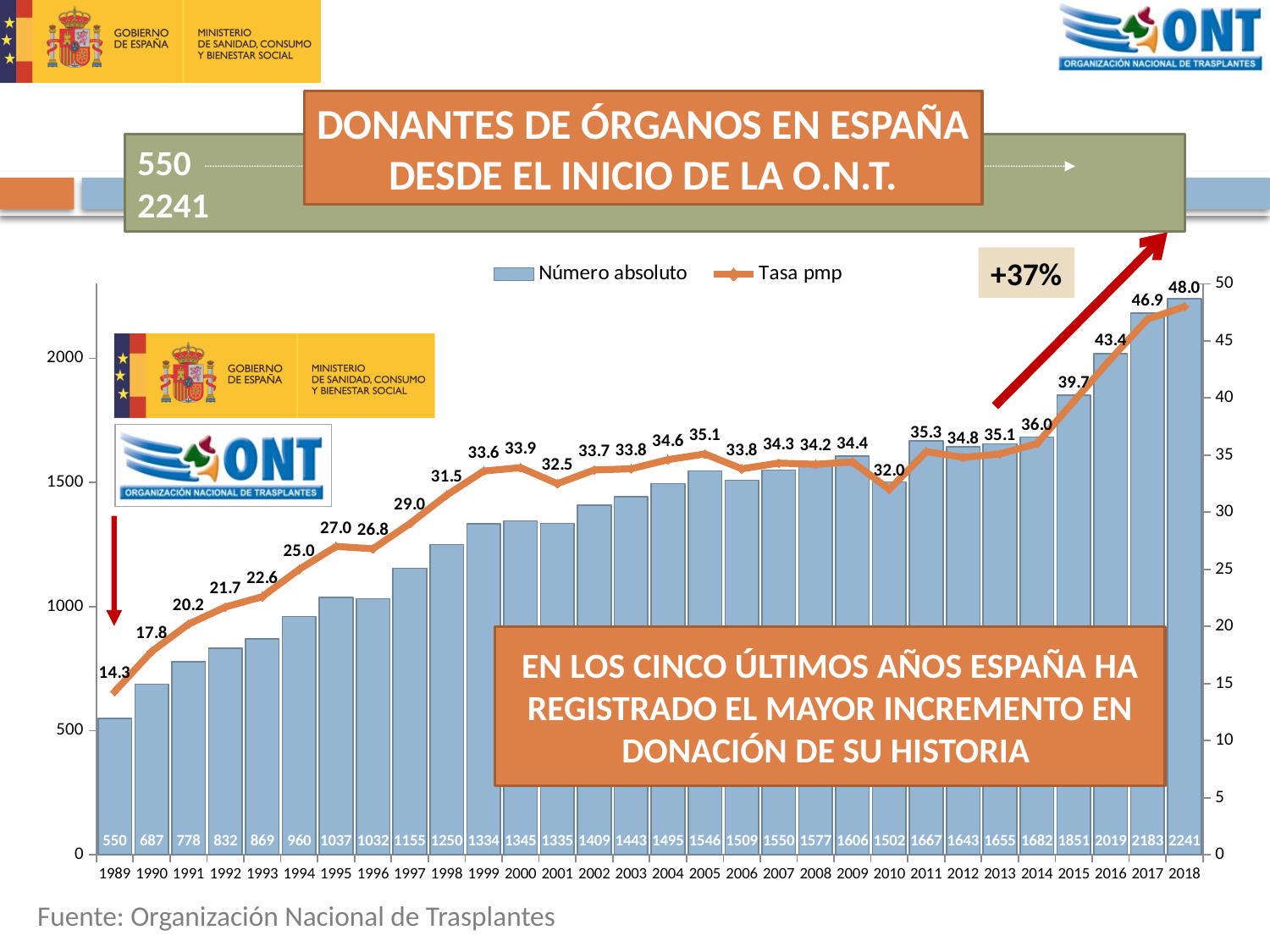
What percentage increase is annotated near the top right of the chart? +37% What kind of chart is used for the 'Número absoluto' series? Bar chart What is the difference between the 'Número absoluto' values for 2018 and 1989? 1691 How many series does the legend list? 2 Which year has the lowest 'Tasa pmp' value? 1989 How many years are shown on the x axis? 30 What is the 'Tasa pmp' value for 2016? 43.4 What is the 'Número absoluto' value for 2010? 1502 Which is larger, the 'Número absoluto' value for 2009 or for 2010? 2009 What is the 'Número absoluto' value for 2018? 2241 Which year has the highest 'Número absoluto' value? 2018 What is the 'Tasa pmp' value for 1989? 14.3